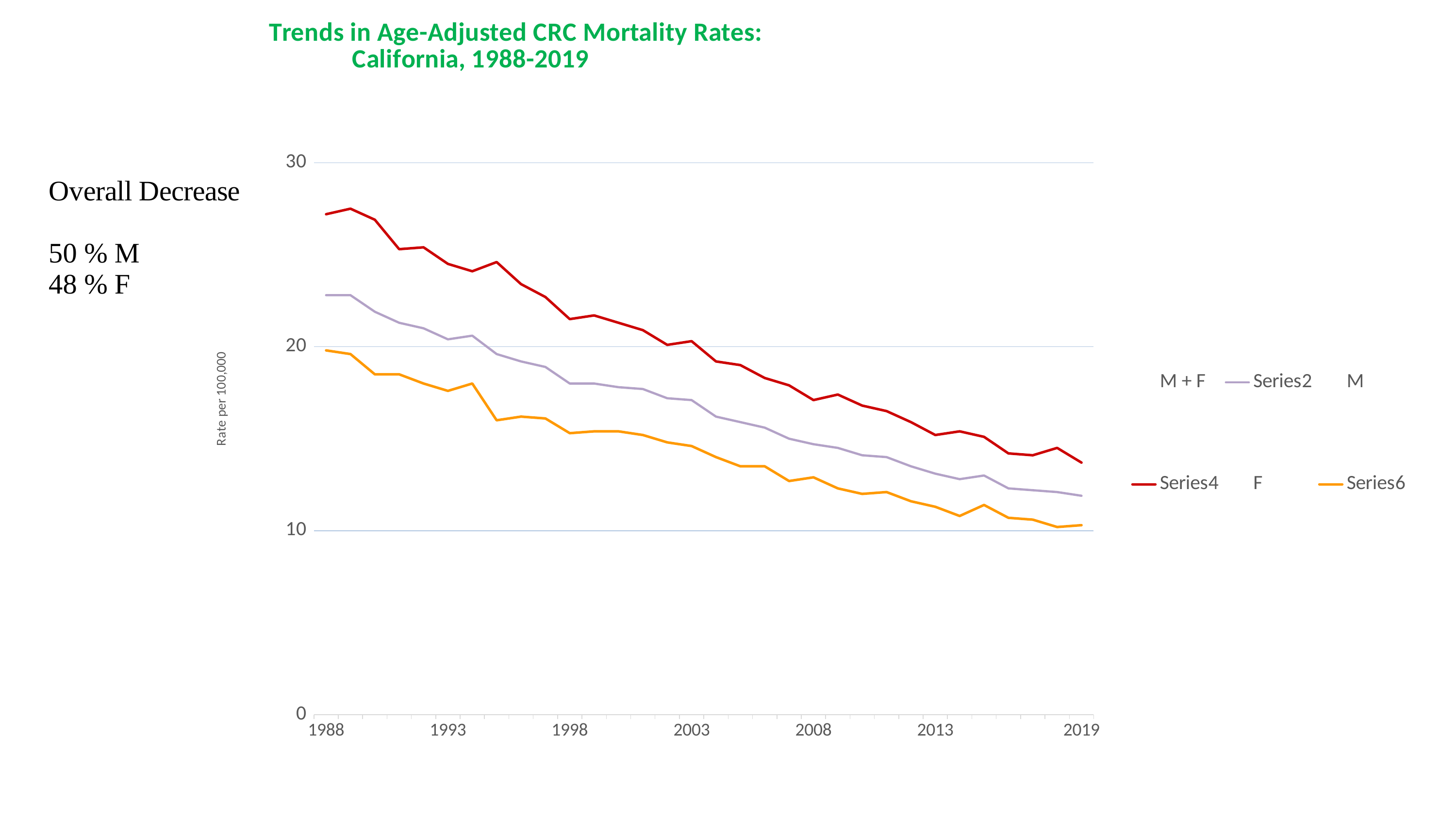
Is the value of the orange line (Series6) in 2019 greater or less than 20? less In 1988, which line has the larger value: the red line (Series4) or the orange line (Series6)? Series4 Which plotted line has the highest values across the chart: Series2, Series4 or Series6? Series4 Is the value of the red line (Series4) in 1988 greater or less than 20? greater Do the values of the orange line (Series6) rise or fall from 1988 to 2019? fall Which plotted line has the lowest values across the chart: Series2, Series4 or Series6? Series6 What is the title of the chart? Trends in Age-Adjusted CRC Mortality Rates: California, 1988-2019 Is the value of the red line (Series4) in 2019 greater or less than 20? less What is the label on the vertical axis of the chart? Rate per 100,000 What kind of chart is shown on the slide? line chart Do the values of the red line (Series4) rise or fall from 1988 to 2019? fall How many entries does the chart's legend list? 6